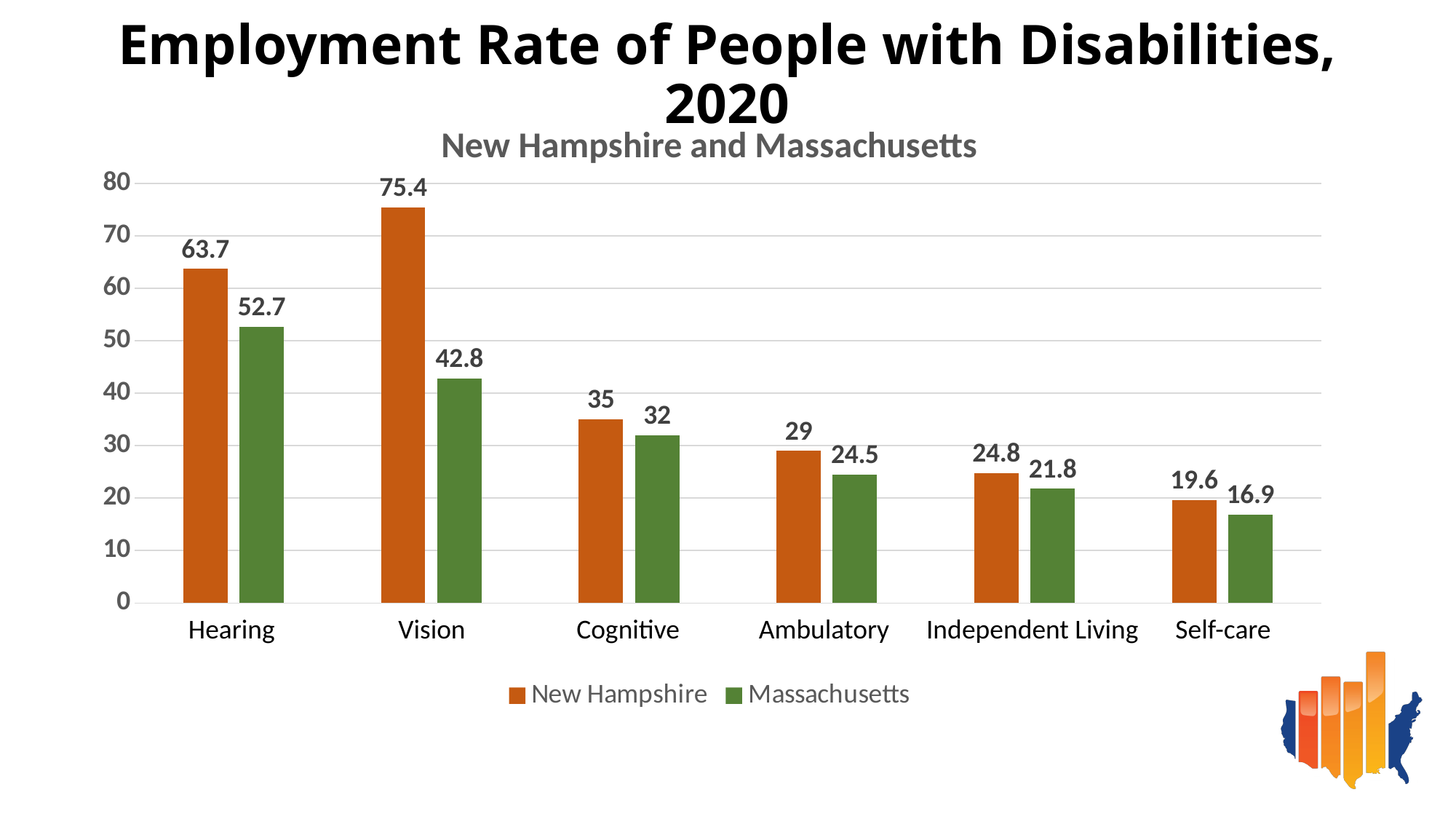
How many disability categories are shown on the x axis? 6 Is the New Hampshire employment rate for Ambulatory greater or less than 20? greater How many series does the legend list? 2 Which category has the highest employment rate for New Hampshire? Vision What is the difference between the New Hampshire and Massachusetts employment rates in the Vision category? 32.6 What is the difference between the New Hampshire and Massachusetts employment rates in the Cognitive category? 3 What is the employment rate for Massachusetts in the Hearing category? 52.7 Which category has the lowest employment rate for Massachusetts? Self-care What is the employment rate for New Hampshire in the Vision category? 75.4 What is the employment rate for Massachusetts in the Self-care category? 16.9 Which is larger, the Massachusetts employment rate for Hearing or for Vision? Hearing What kind of chart is shown on the slide? Bar chart